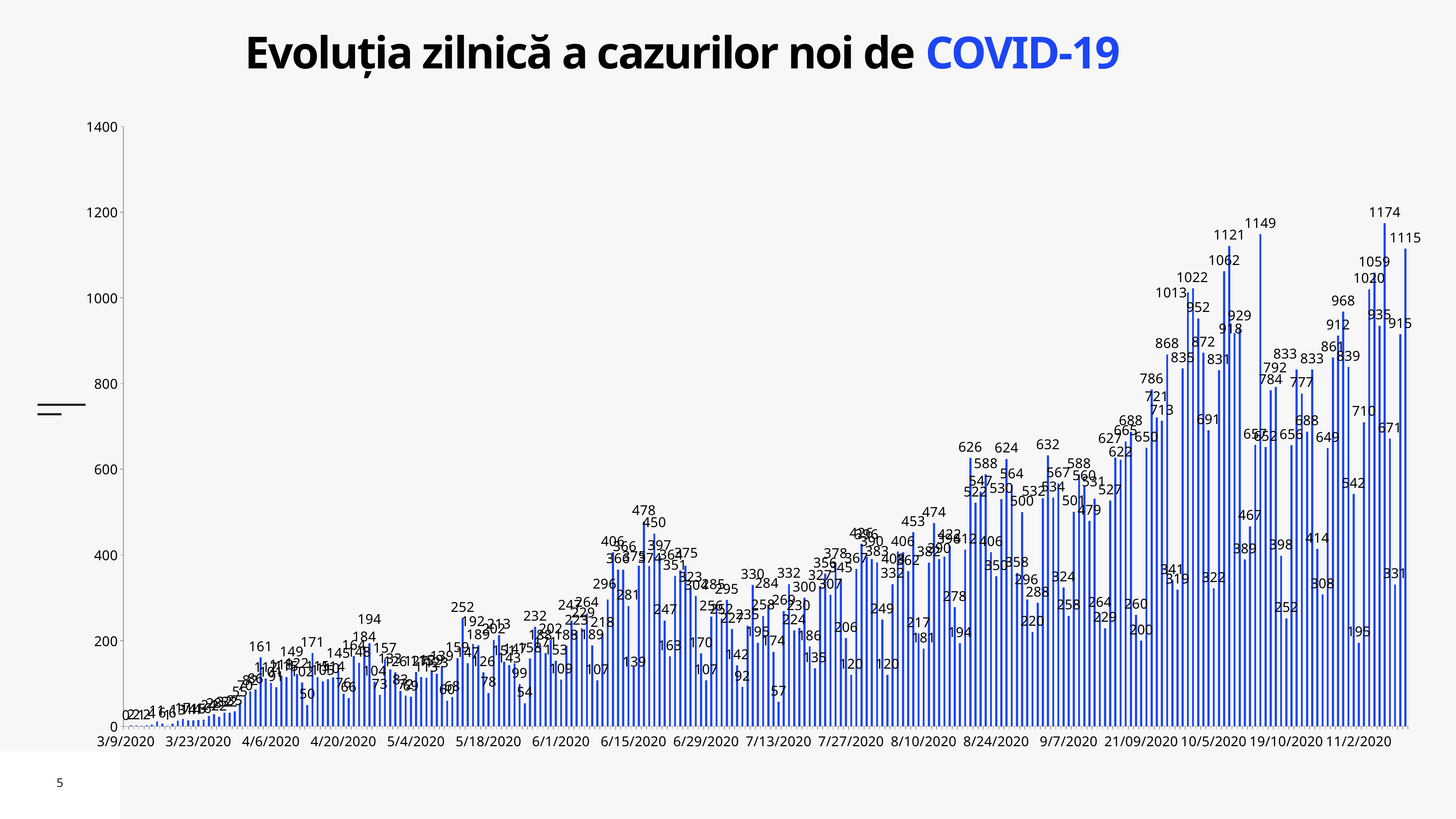
Is the value of the first bar at 3/9/2020 greater or less than 200? less What is the highest tick value shown on the y axis? 1400 What is the highest daily value labeled on the chart? 1174 What kind of chart is shown on the slide? bar chart Which is larger, the peak value labeled near 6/15/2020 (478) or the peak value labeled near 8/24/2020 (626)? 626 How many date labels are shown on the x axis? 18 What is the second highest daily value labeled on the chart? 1149 Overall, do the daily values rise or fall from March 2020 to November 2020? rise What is the difference between the highest labeled value (1174) and the rightmost bar's value (1115)? 59 Is the value of the rightmost bar greater or less than 1000? greater What is the value of the rightmost bar on the chart? 1115 What is the title of the chart? Evoluția zilnică a cazurilor noi de COVID-19